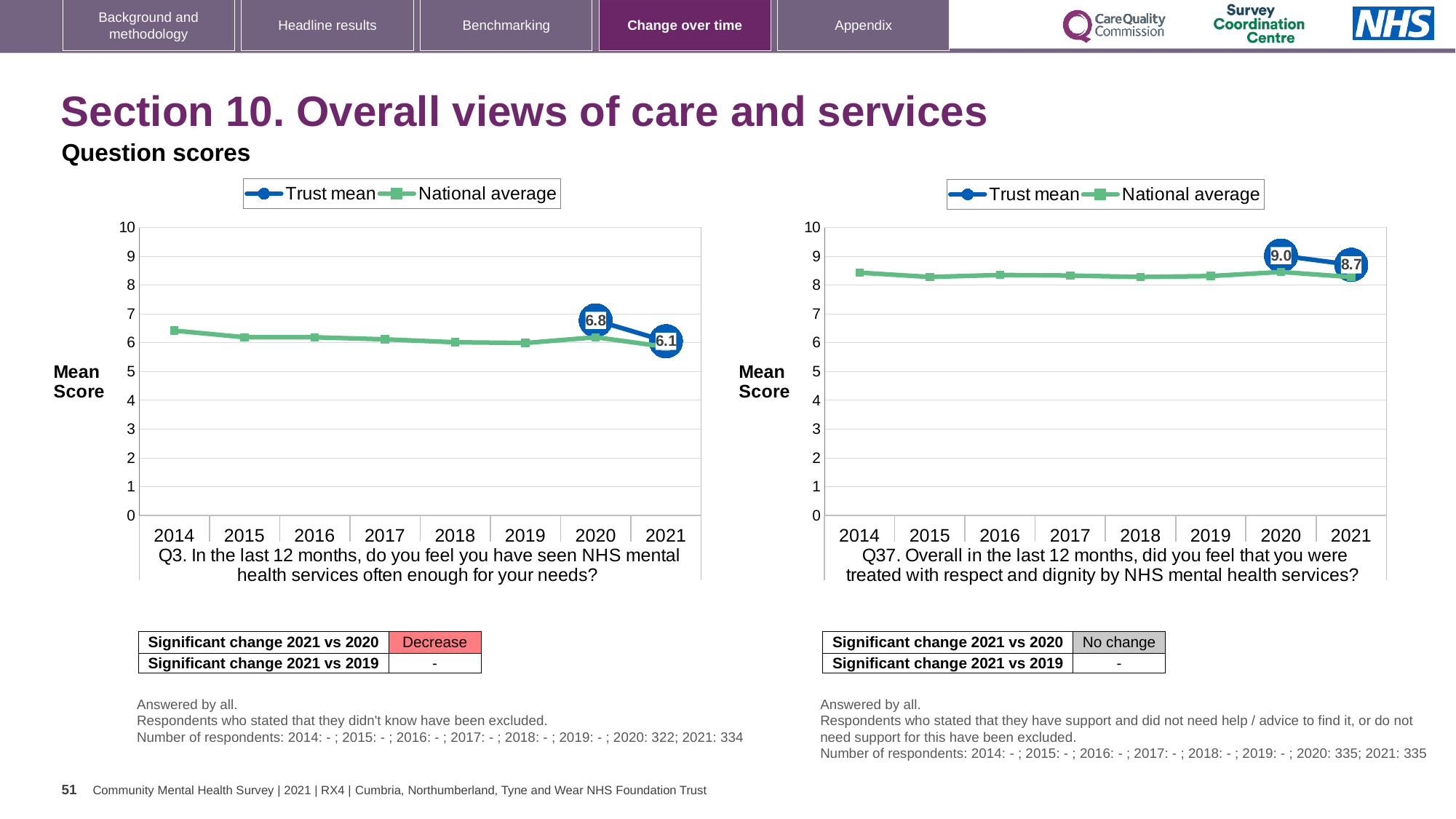
On the Q3 chart (left), what is the Trust mean for 2020? 6.8 On the Q37 chart (right), what is the Trust mean for 2020? 9.0 On the Q3 chart (left), is the National average for 2014 greater or less than 6? greater On the Q37 chart (right), what is the difference between the Trust mean in 2020 and in 2021? 0.3 On the Q37 chart (right), is the National average for 2015 greater or less than 9? less What kind of chart is the Q37 chart (right)? line chart On the Q3 chart (left), did the Trust mean rise or fall from 2020 to 2021? fall On the Q37 chart (right), is the Trust mean for 2020 greater or less than the Trust mean for 2021? greater On the Q3 chart (left), what is the difference between the Trust mean in 2020 and in 2021? 0.7 How many series does the legend of the Q3 chart (left) list? 2 On the Q3 chart (left), what is the Trust mean for 2021? 6.1 On the Q37 chart (right), what is the Trust mean for 2021? 8.7